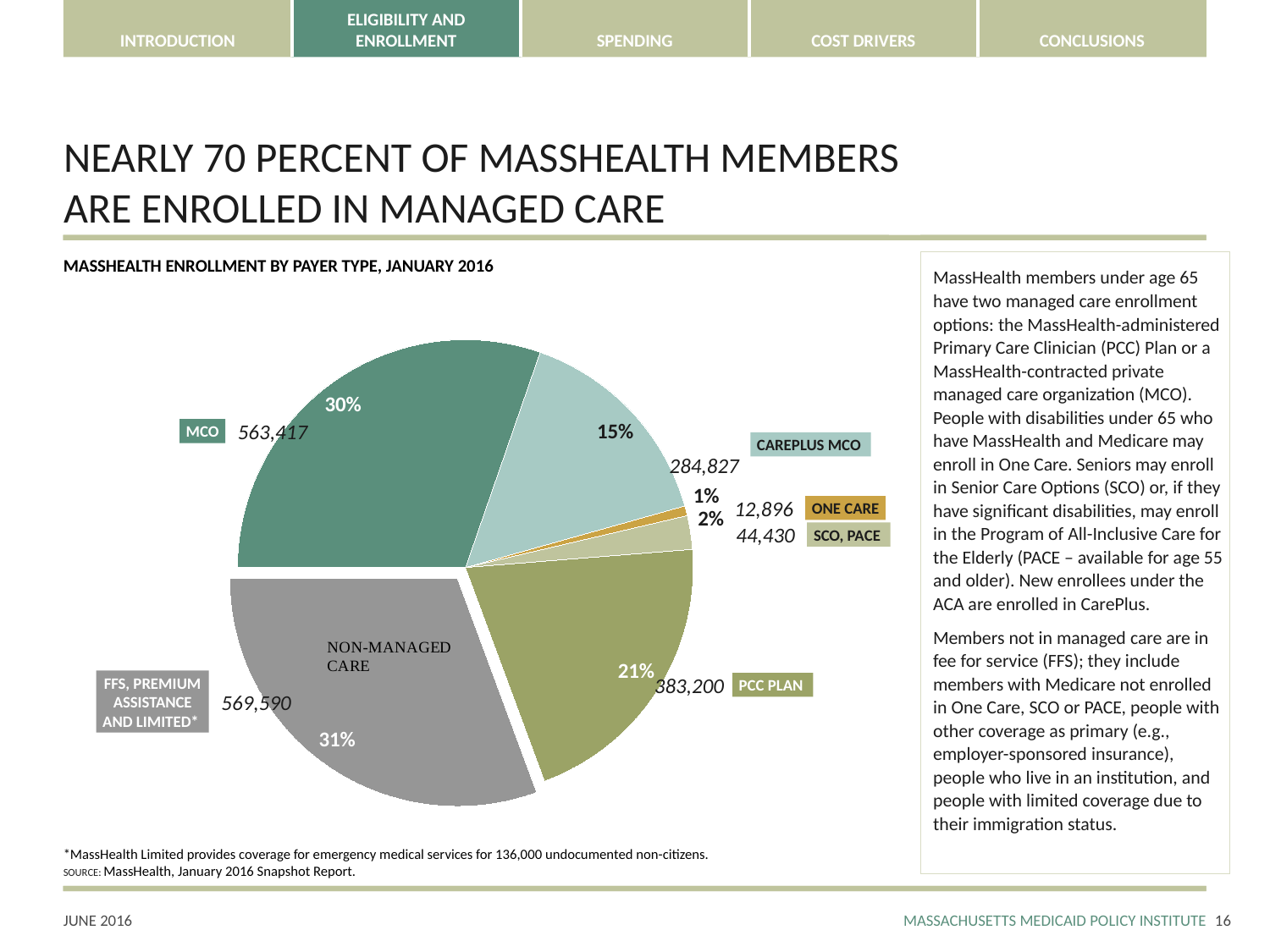
Which has higher enrollment, MCO or the PCC Plan? MCO How many payer type slices are shown in the pie chart? 6 What percentage of the pie does the FFS, Premium Assistance and Limited slice represent? 31% What is the enrollment value shown for CarePlus MCO? 284,827 What is the enrollment value shown for MCO? 563,417 What percentage of the pie does the SCO, PACE slice represent? 2% Which payer type has the largest enrollment? FFS, Premium Assistance and Limited Which payer type has the smallest enrollment? One Care What is the enrollment value shown for the PCC Plan? 383,200 What type of chart is shown on the slide? Pie chart What is the enrollment value shown for One Care? 12,896 What is the difference in enrollment between the PCC Plan and CarePlus MCO? 98,373